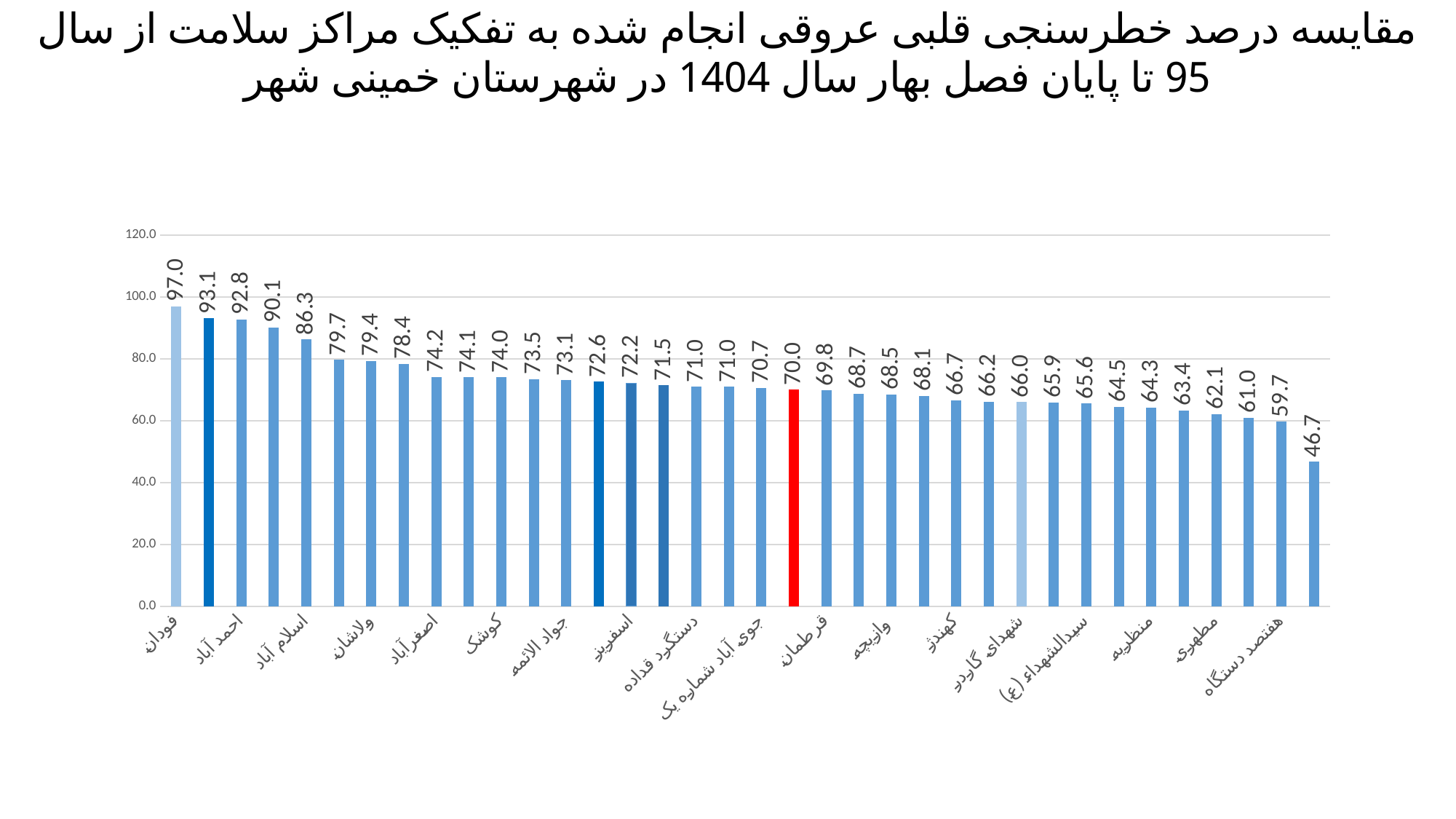
What is the value for فودان? 97.0 What is the value for هفتصد دستگاه? 59.7 Which center has the highest value in the chart? فودان Is the value for فودان greater or less than 80.0? greater Do the values rise or fall moving from left to right along the x axis? fall What is the value of the red bar in the chart? 70.0 What is the difference between the highest value (97.0) and the lowest value (46.7)? 50.3 What is the lowest value shown in the chart? 46.7 What is the maximum value shown on the vertical axis? 120.0 What is the highest value shown in the chart? 97.0 What kind of chart is shown on the slide? bar chart How many bars are plotted in the chart? 36